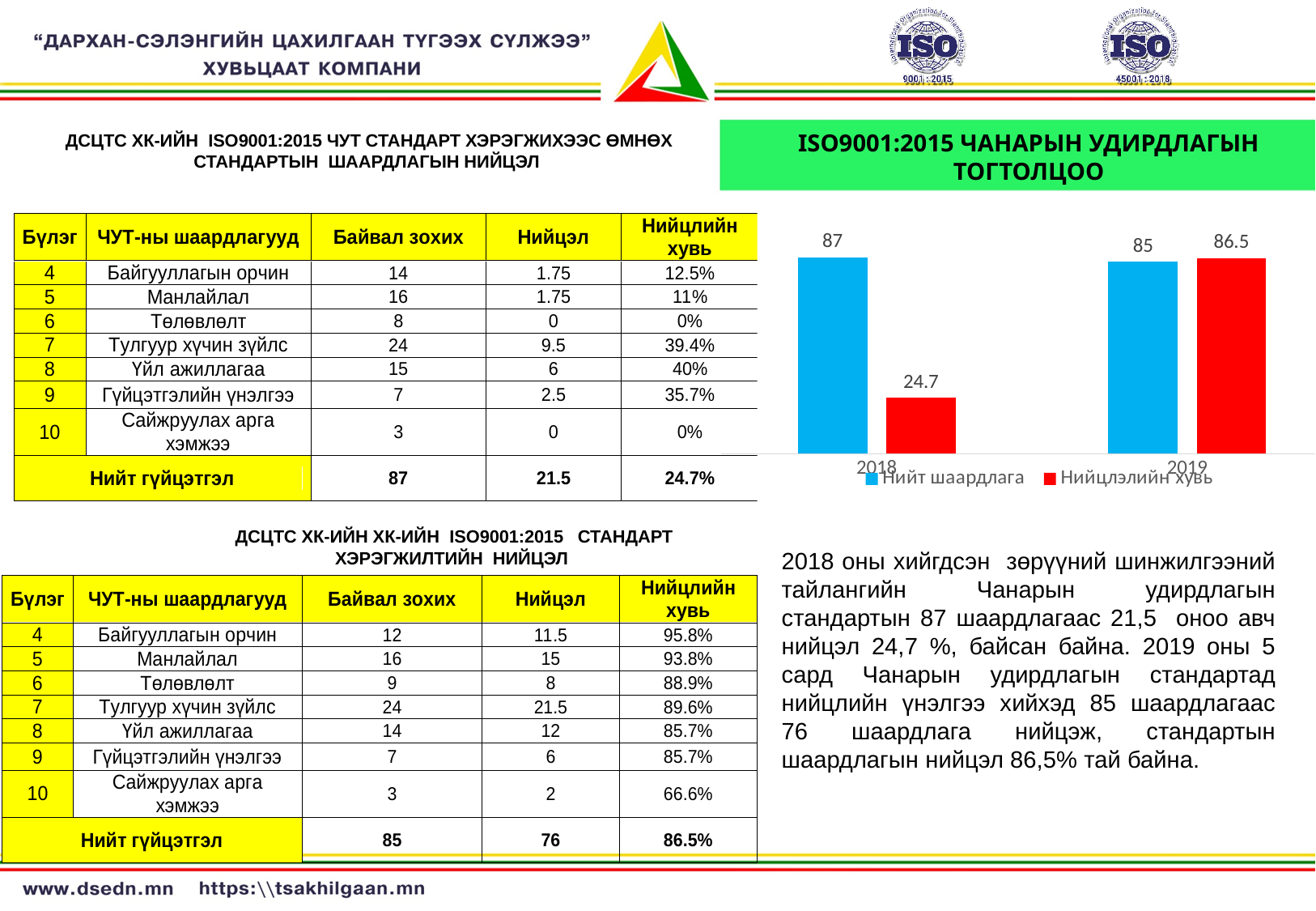
What is the value of Нийт шаардлага for 2019? 85 Does the value of Нийцлэлийн хувь rise or fall from 2018 to 2019? rise Which colour represents the Нийт шаардлага series in the chart? blue How many categories are shown on the x axis of the chart? 2 What is the value of Нийцлэлийн хувь for 2018? 24.7 How many series does the chart legend list? 2 What is the value of Нийцлэлийн хувь for 2019? 86.5 What is the value of Нийт шаардлага for 2018? 87 Which year has the higher value for Нийцлэлийн хувь? 2019 Which year has the lower value for Нийт шаардлага? 2019 What type of chart is shown on the slide? bar chart What is the difference between the Нийцлэлийн хувь values for 2019 and 2018? 61.8